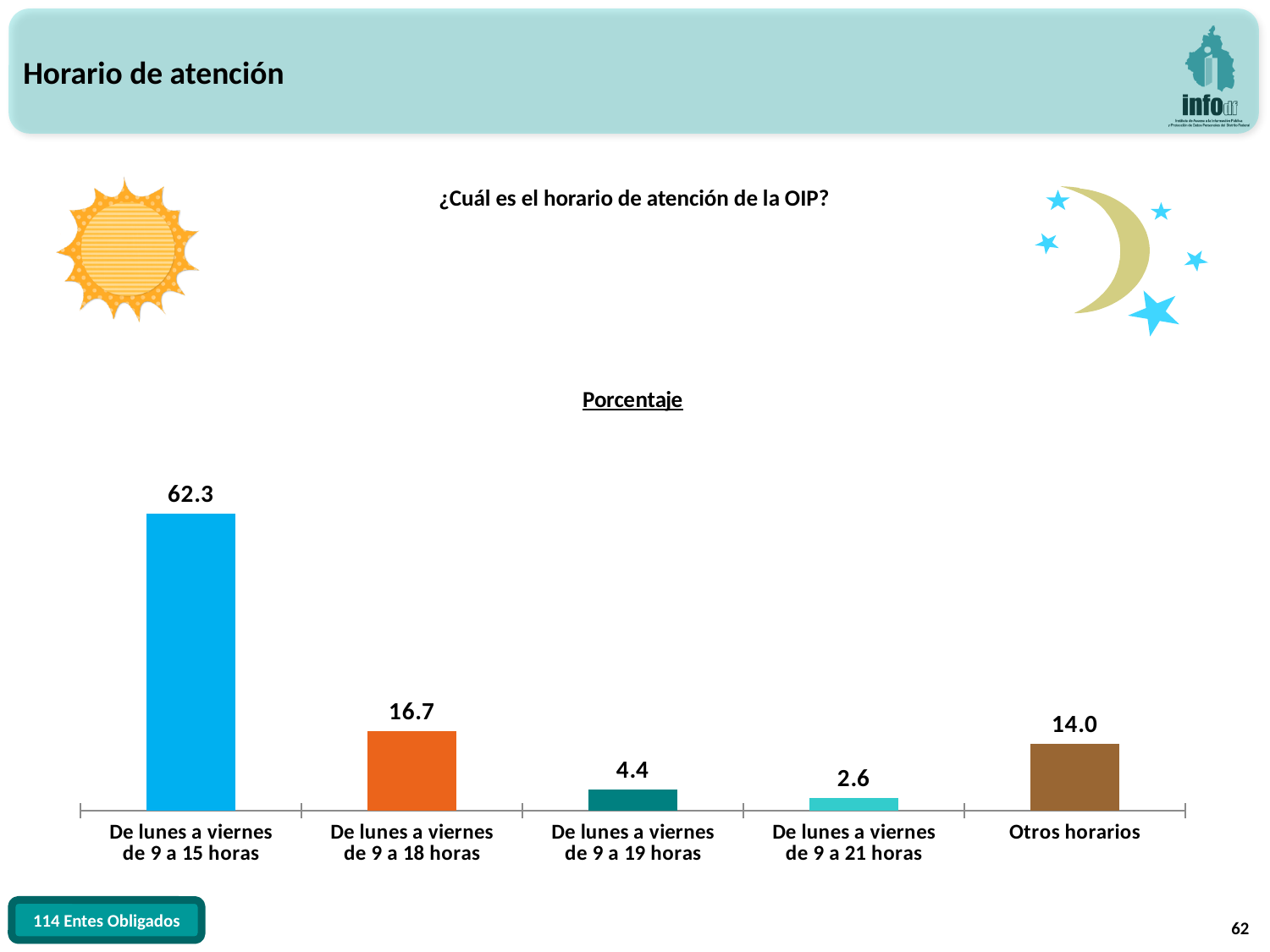
What is the value for 'Otros horarios'? 14.0 What is the value for 'De lunes a viernes de 9 a 21 horas'? 2.6 How many categories are shown in the chart? 5 What is the difference between the values for 'De lunes a viernes de 9 a 19 horas' and 'De lunes a viernes de 9 a 21 horas'? 1.8 Which category has the lowest value? De lunes a viernes de 9 a 21 horas What is the difference between the values for 'De lunes a viernes de 9 a 15 horas' and 'De lunes a viernes de 9 a 18 horas'? 45.6 What is the label shown above the chart indicating the unit of the values? Porcentaje Which is larger, the value for 'De lunes a viernes de 9 a 18 horas' or 'Otros horarios'? De lunes a viernes de 9 a 18 horas What is the value for 'De lunes a viernes de 9 a 15 horas'? 62.3 What is the value for 'De lunes a viernes de 9 a 18 horas'? 16.7 Which category has the highest value? De lunes a viernes de 9 a 15 horas What kind of chart is shown on the slide? Bar chart